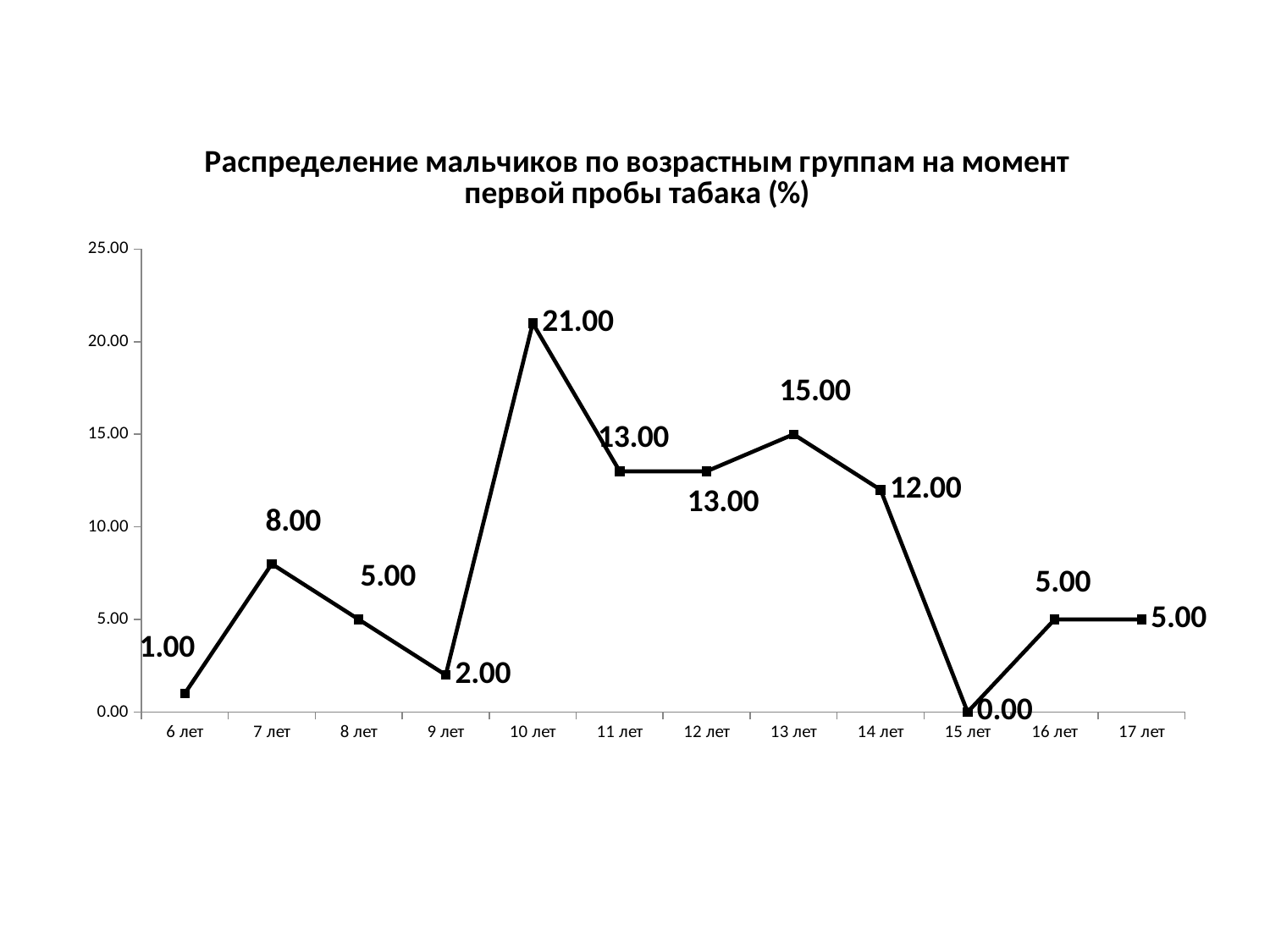
Which is larger, the value for 7 лет or the value for 8 лет? 7 лет What is the difference between the values for 10 лет and 13 лет? 6.00 What is the value for 10 лет? 21.00 Do the values rise or fall from 10 лет to 11 лет? fall Is the value for 11 лет greater or less than 10.00? greater Which age group has the lowest value? 15 лет What is the value for 14 лет? 12.00 What kind of chart is this? line chart Which age group has the highest value? 10 лет How many age groups are shown on the x axis? 12 What is the title of the chart? Распределение мальчиков по возрастным группам на момент первой пробы табака (%) What is the value for 7 лет? 8.00